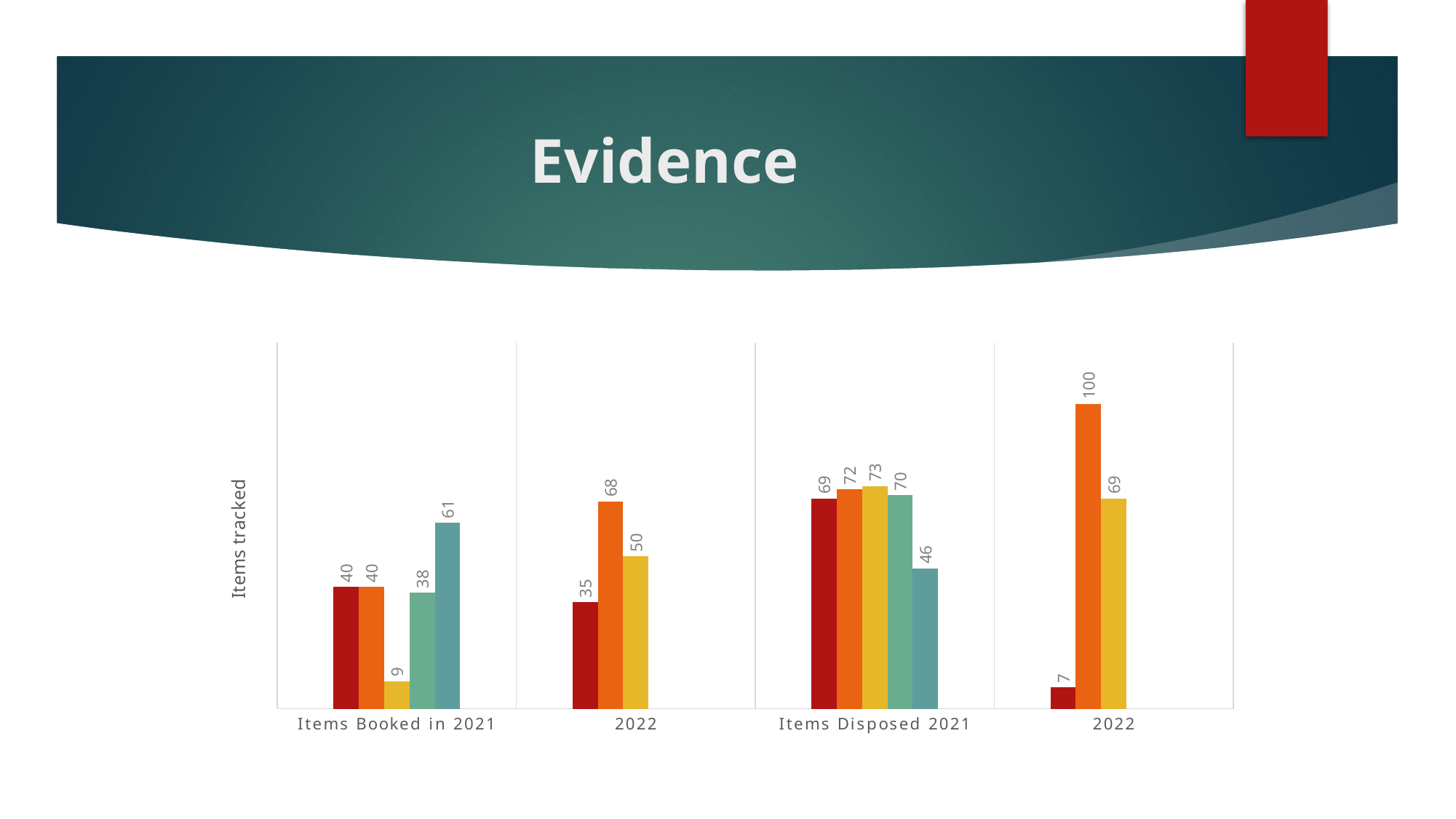
What is the highest value labelled anywhere on the chart? 100 What is the highest value in the 'Items Disposed 2021' group? 73 What kind of chart is shown on the slide? bar chart How many bars are in the 'Items Disposed 2021' group? 5 What is the lowest value labelled anywhere on the chart? 7 What is the value of the dark red bar in the 'Items Booked in 2021' group? 40 What is the value of the orange bar in the '2022' group next to 'Items Booked in 2021'? 68 What is the lowest value in the 'Items Booked in 2021' group? 9 Which group has the larger teal bar: 'Items Booked in 2021' or 'Items Disposed 2021'? Items Booked in 2021 How many categories are shown along the x axis of the chart? 4 In the rightmost '2022' group, what is the difference between the orange bar (100) and the yellow bar (69)? 31 What is the label on the vertical axis of the chart? Items tracked